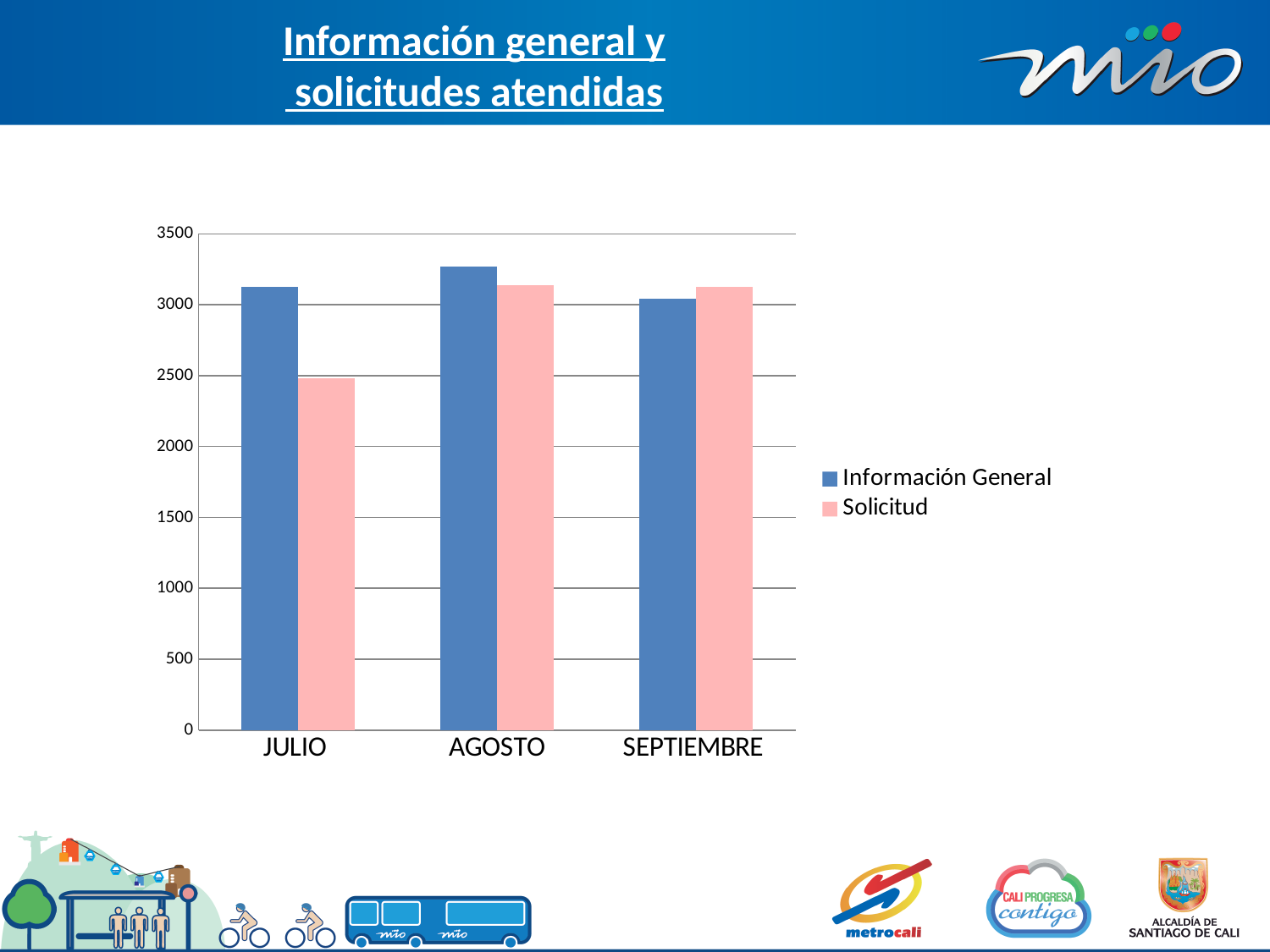
In AGOSTO, which is larger: Información General or Solicitud? Información General What kind of chart is shown on the slide? bar chart What are the two series named in the legend? Información General and Solicitud Is the Solicitud value for AGOSTO greater or less than 3000? greater In JULIO, which is larger: Información General or Solicitud? Información General In which month is the Solicitud value lowest? JULIO Does the Solicitud value rise or fall from JULIO to AGOSTO? rise Is the Solicitud value for JULIO greater or less than 2000? greater How many months are shown on the x axis of the chart? 3 Is the Información General value for AGOSTO greater or less than 3000? greater How many series does the chart legend list? 2 In which month is the Información General value highest? AGOSTO